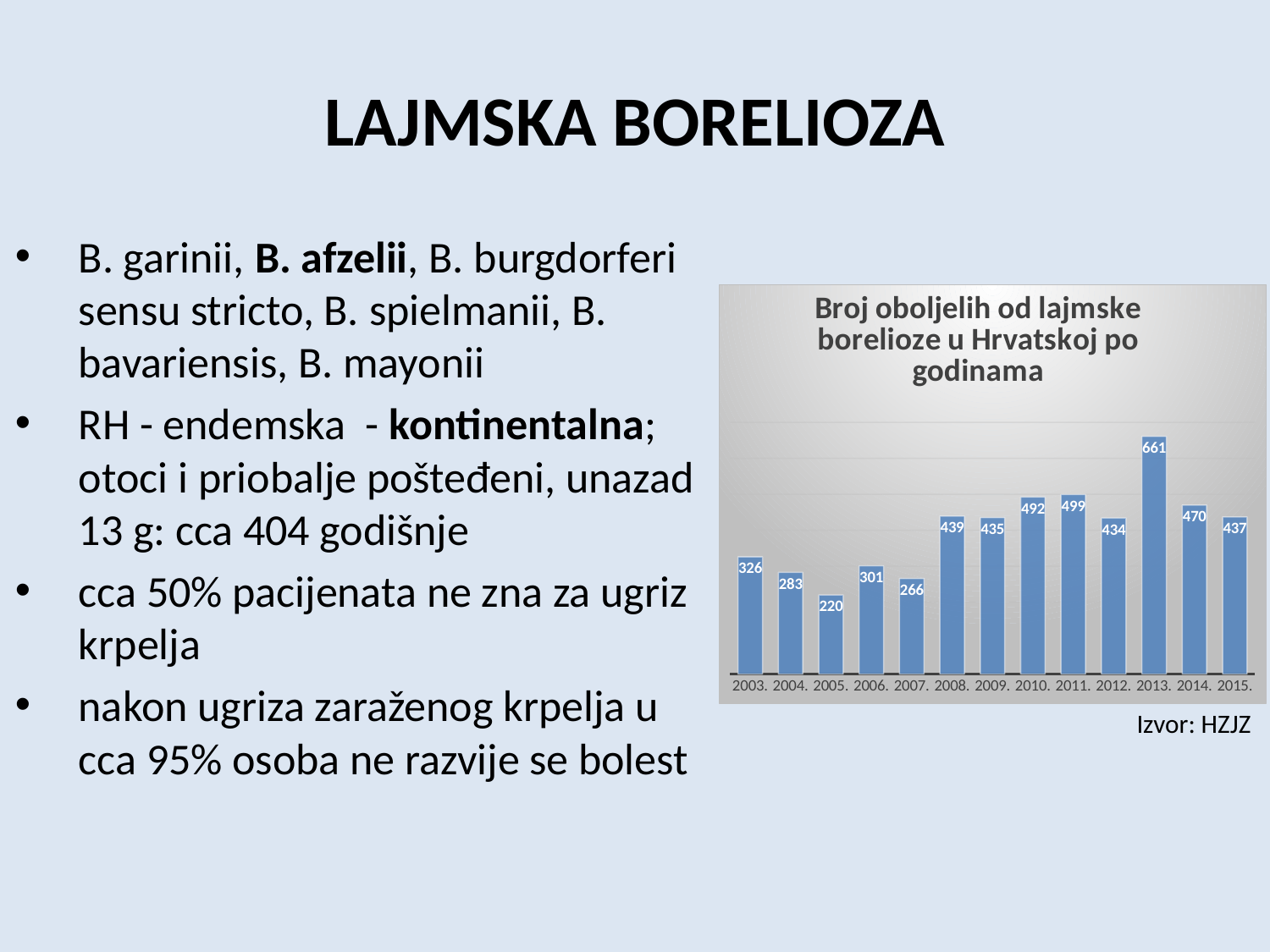
What is the difference between the values for 2003. and 2004.? 43 Which year has the highest value in the chart? 2013. What is the value for 2013. in the chart? 661 Which is larger, the value for 2008. or the value for 2009.? 2008. Which is larger, the value for 2006. or the value for 2007.? 2006. How many years are shown on the x axis of the chart? 13 Which year has the lowest value in the chart? 2005. What is the title of the chart? Broj oboljelih od lajmske borelioze u Hrvatskoj po godinama What is the value for 2005. in the chart? 220 What is the difference between the values for 2013. and 2014.? 191 What kind of chart is shown on the slide? bar chart What is the value for 2010. in the chart? 492